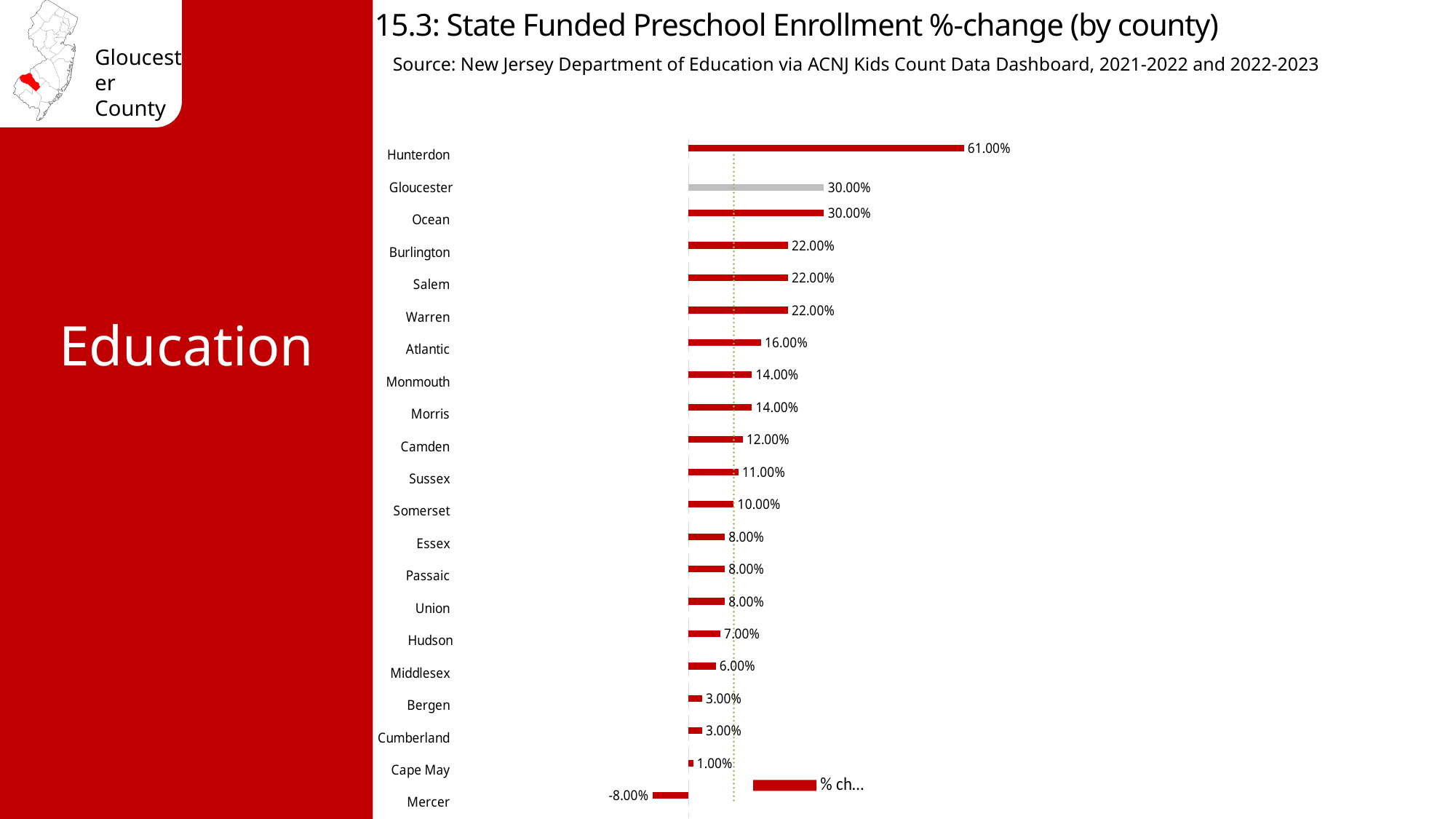
How many counties are shown in the chart? 21 Which is larger, the value for Somerset or the value for Middlesex? Somerset What is the difference between the values for Burlington and Camden? 10.00% What is the value shown for Gloucester? 30.00% Which county has the lowest %-change? Mercer What is the value shown for Atlantic? 16.00% What kind of chart is shown on the slide? Bar chart What is the difference between the values for Hunterdon and Ocean? 31.00% Which county's bar is coloured grey instead of red? Gloucester What is the state funded preschool enrollment %-change for Hunterdon? 61.00% What is the value shown for Mercer? -8.00% Which county has the highest %-change? Hunterdon